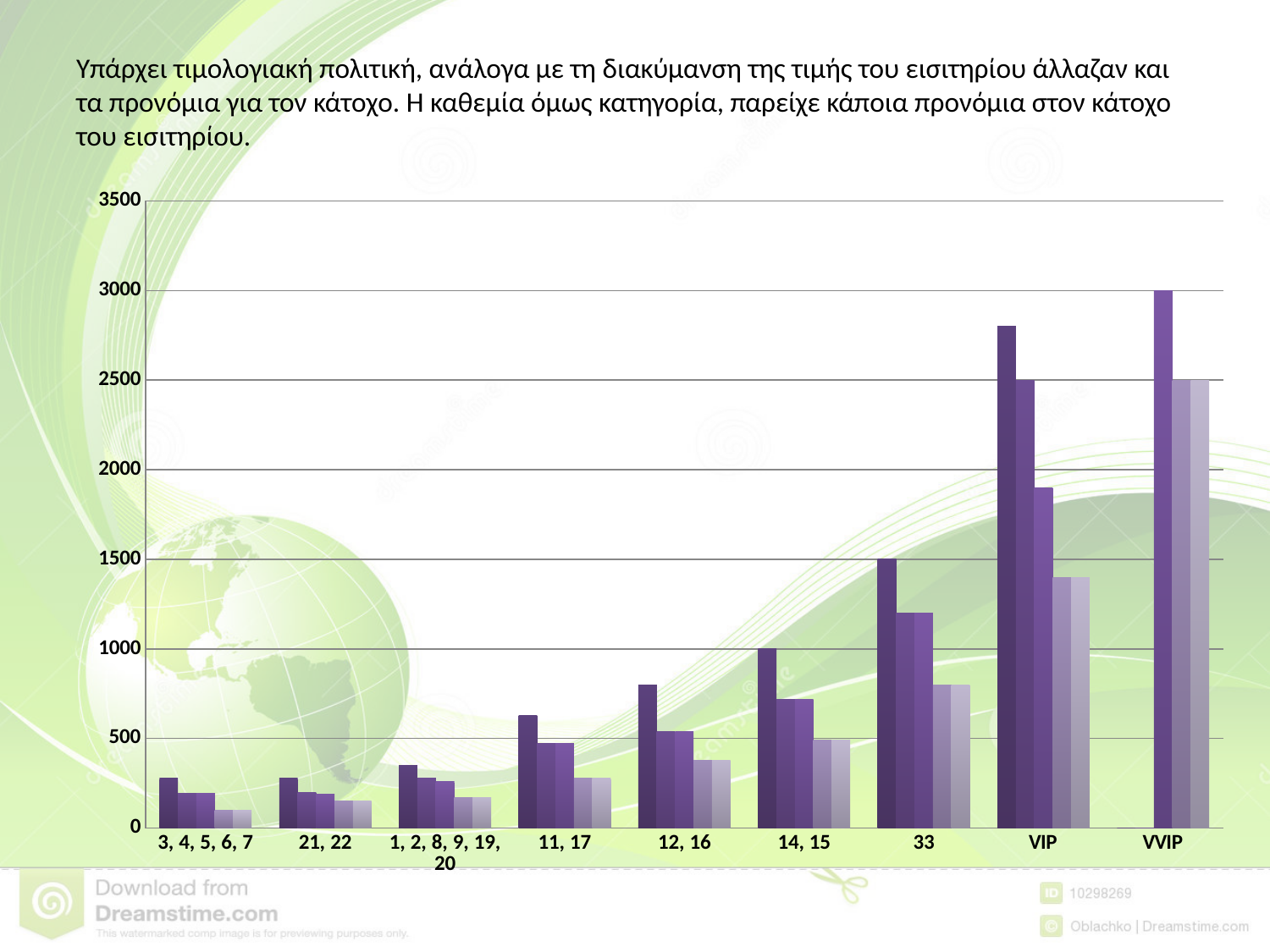
Is the value of the first (darkest) bar for 12, 16 greater or less than 1000? less Do the bar values generally rise or fall moving from left to right along the x axis? rise How many categories are shown along the x axis of the chart? 9 What is the value of the tallest (first) bar for VVIP? 3000 What kind of chart is shown on the slide? bar chart How many bars are plotted for each category in the chart? 5 What is the value of the first (darkest) bar for the category 14, 15? 1000 Which category has the tallest bar in the chart? VVIP What is the value of the first (darkest) bar for the category 33? 1500 Is the value of the first (darkest) bar for 11, 17 greater or less than 500? greater Which has the taller first (darkest) bar, VIP or 33? VIP Is the value of the first (darkest) bar for VIP greater or less than 2500? greater